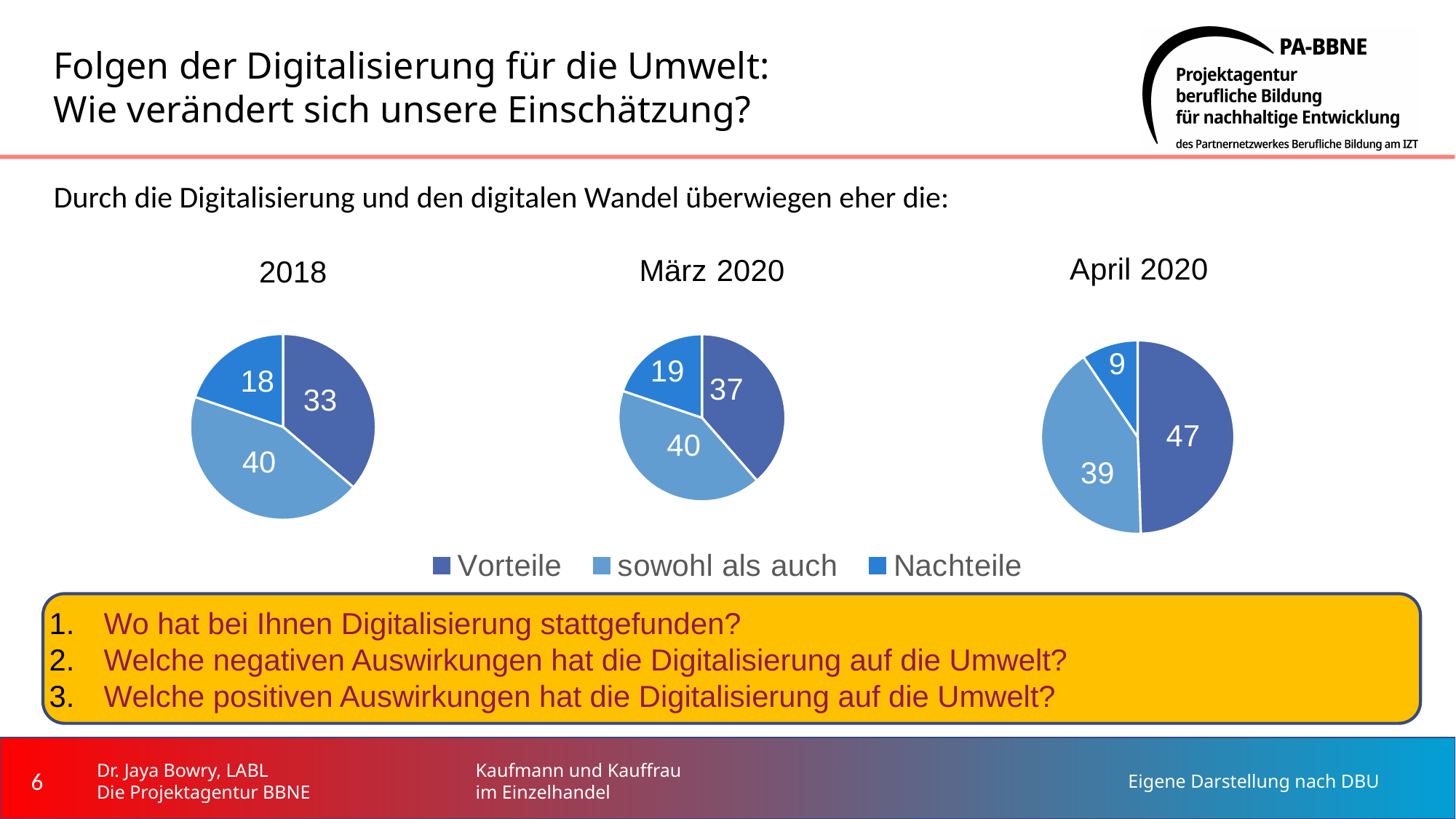
In the März 2020 pie chart, what is the value for Nachteile? 19 In the 2018 pie chart, which is larger: Vorteile or sowohl als auch? sowohl als auch In the April 2020 pie chart, what is the difference between Vorteile and Nachteile? 38 How many entries does the shared legend list? 3 In the 2018 pie chart, which category has the smallest slice? Nachteile In the März 2020 pie chart, which category has the largest slice? sowohl als auch In the April 2020 pie chart, what is the value for sowohl als auch? 39 What type of charts are shown on the slide? Pie charts In the April 2020 pie chart, which category has the largest slice? Vorteile Comparing the Nachteile slices, which chart has the smaller value: März 2020 or April 2020? April 2020 In the 2018 pie chart, what is the value for Vorteile? 33 How many slices does each pie chart on the slide have? 3